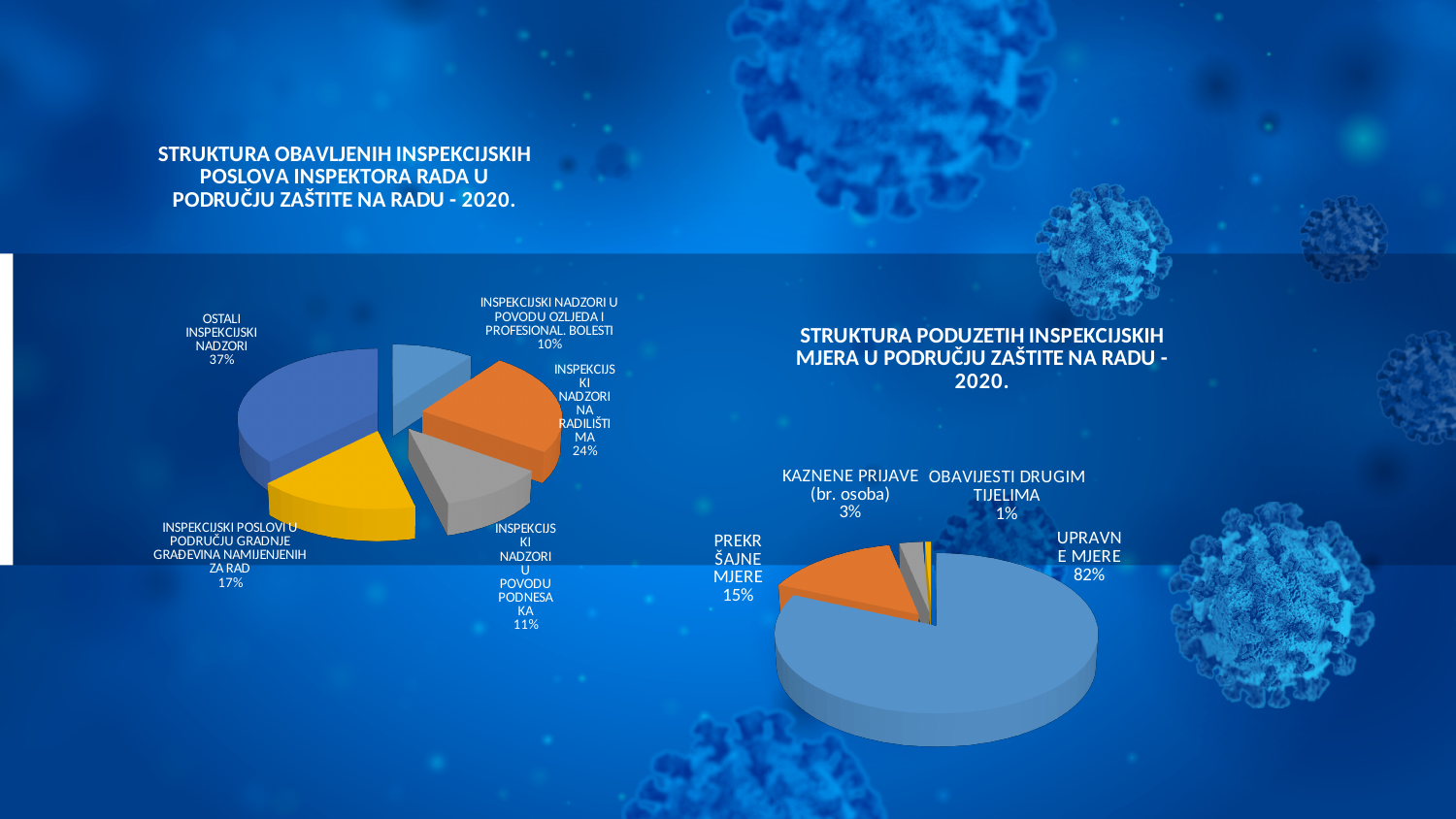
In the left pie chart (STRUKTURA OBAVLJENIH INSPEKCIJSKIH POSLOVA), how many slices does the pie have? 5 In the left pie chart (STRUKTURA OBAVLJENIH INSPEKCIJSKIH POSLOVA), which category has the smallest share? INSPEKCIJSKI NADZORI U POVODU OZLJEDA I PROFESIONAL. BOLESTI In the right pie chart (STRUKTURA PODUZETIH INSPEKCIJSKIH MJERA), which category has the smallest share? OBAVIJESTI DRUGIM TIJELIMA In the left pie chart (STRUKTURA OBAVLJENIH INSPEKCIJSKIH POSLOVA), what share is labelled for OSTALI INSPEKCIJSKI NADZORI? 37% In the left pie chart (STRUKTURA OBAVLJENIH INSPEKCIJSKIH POSLOVA), what is the difference in percentage points between OSTALI INSPEKCIJSKI NADZORI and INSPEKCIJSKI POSLOVI U PODRUČJU GRADNJE GRAĐEVINA NAMIJENJENIH ZA RAD? 20 percentage points In the left pie chart (STRUKTURA OBAVLJENIH INSPEKCIJSKIH POSLOVA), what share is labelled for INSPEKCIJSKI NADZORI NA RADILIŠTIMA? 24% In the right pie chart (STRUKTURA PODUZETIH INSPEKCIJSKIH MJERA), which is larger: KAZNENE PRIJAVE (br. osoba) or PREKRŠAJNE MJERE? PREKRŠAJNE MJERE In the right pie chart (STRUKTURA PODUZETIH INSPEKCIJSKIH MJERA), what share is labelled for UPRAVNE MJERE? 82% In the left pie chart (STRUKTURA OBAVLJENIH INSPEKCIJSKIH POSLOVA), which category has the largest share? OSTALI INSPEKCIJSKI NADZORI What type of chart is used for STRUKTURA PODUZETIH INSPEKCIJSKIH MJERA on the right of the slide? Pie chart In the left pie chart (STRUKTURA OBAVLJENIH INSPEKCIJSKIH POSLOVA), what share is labelled for INSPEKCIJSKI NADZORI U POVODU PODNESAKA? 11% In the right pie chart (STRUKTURA PODUZETIH INSPEKCIJSKIH MJERA), what share is labelled for PREKRŠAJNE MJERE? 15%